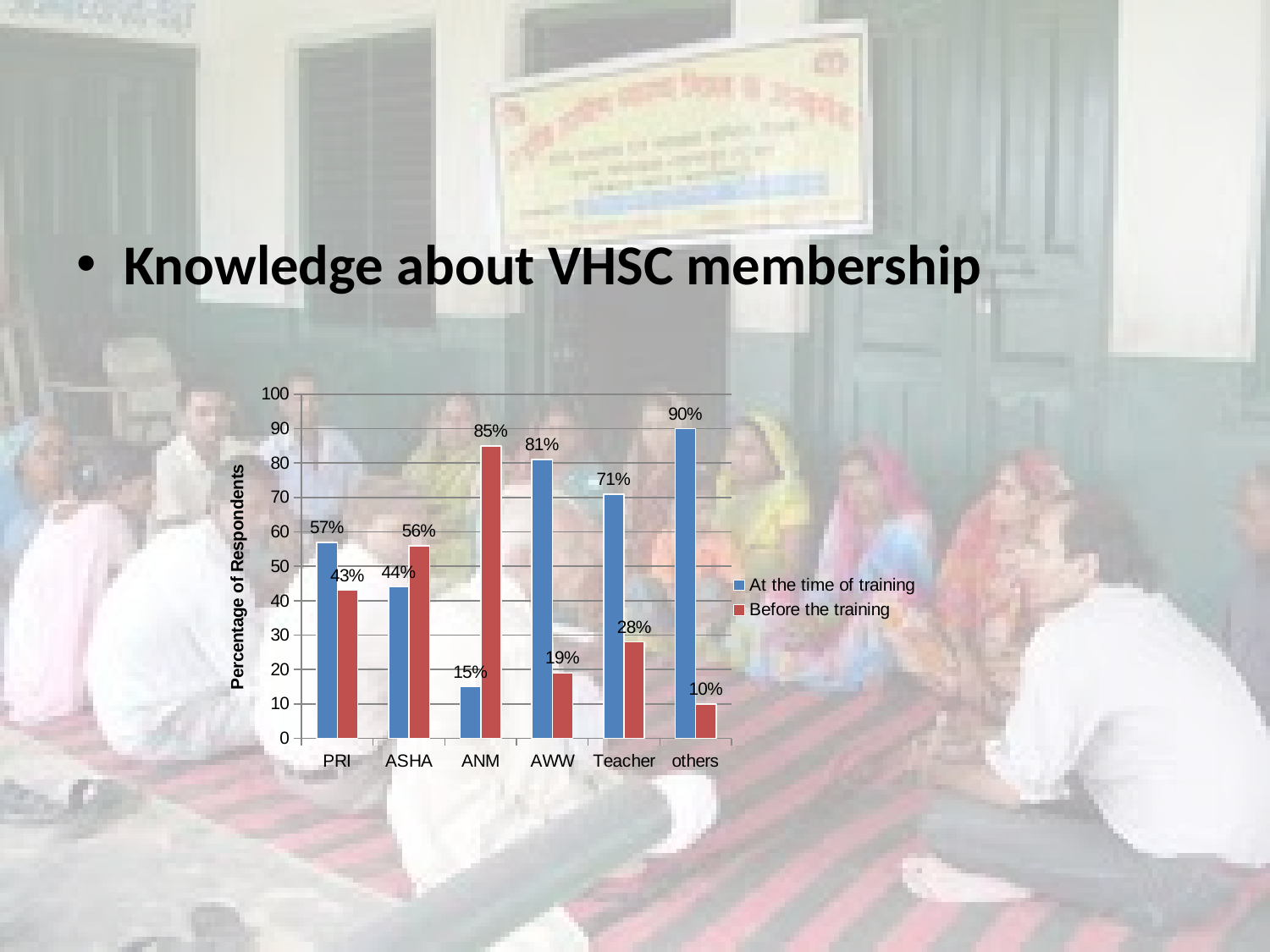
What is the value for ANM in the 'Before the training' series? 85% What is the difference between the 'At the time of training' and 'Before the training' values for AWW? 62% Which category has the lowest value in the 'Before the training' series? others What is the value for PRI in the 'At the time of training' series? 57% What is the value for Teacher in the 'Before the training' series? 28% For ASHA, which series has the larger value: 'At the time of training' or 'Before the training'? Before the training What type of chart is shown on the slide? bar chart How many categories are shown on the x axis? 6 Is the 'At the time of training' value for ANM greater or less than 20? less What is the label of the y axis? Percentage of Respondents Which category has the highest value in the 'At the time of training' series? others How many series does the legend list? 2